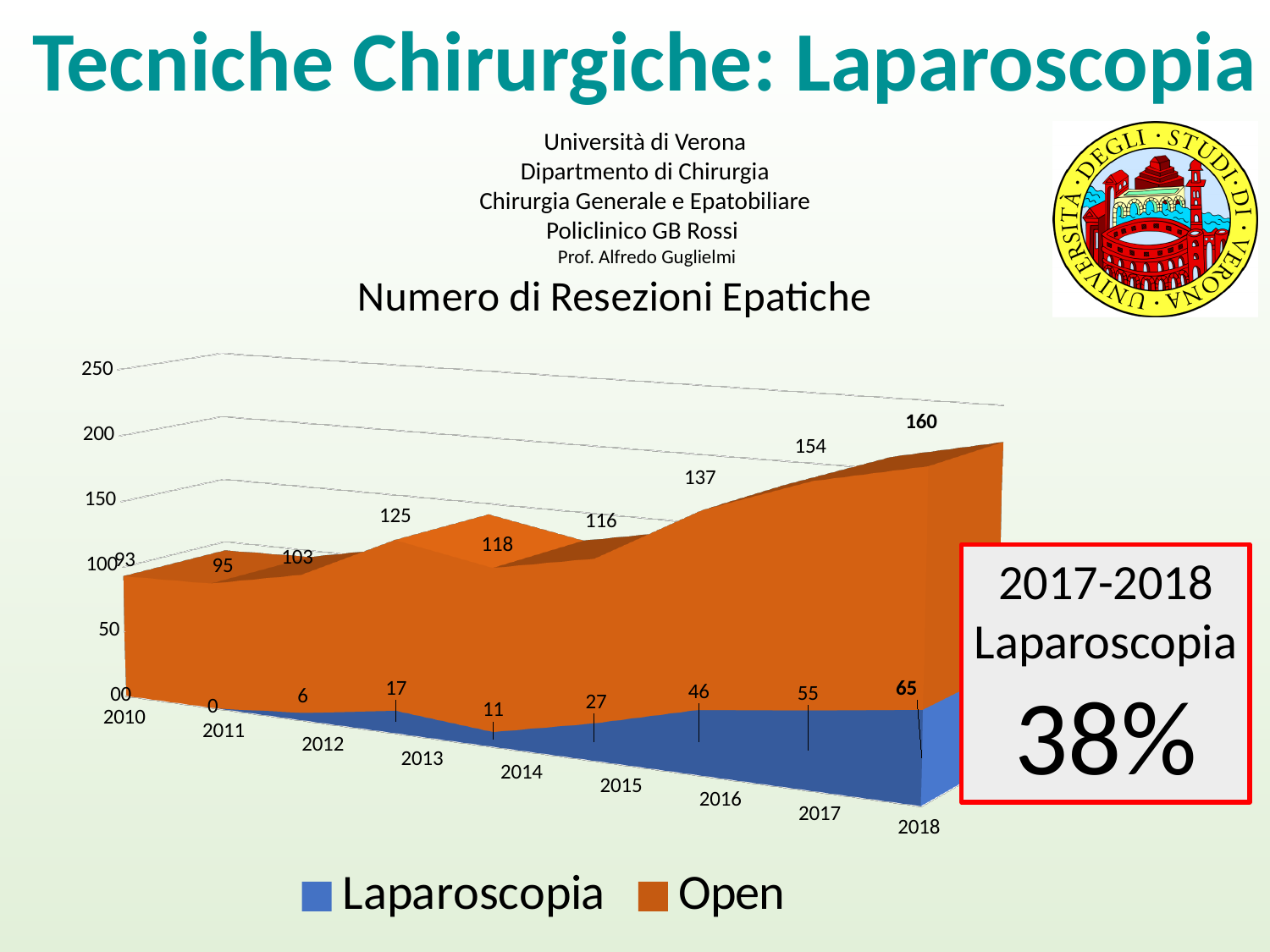
What is the difference between the Open values for 2017 and 2016? 17 What kind of chart is shown? Area chart What is the title of the chart? Numero di Resezioni Epatiche Which is larger, the Laparoscopia value for 2013 or for 2014? 2013 In which year is the Open series lowest? 2010 What is the value for Laparoscopia in 2014? 11 What is the value for Open in 2018? 160 In which year is the Open series highest? 2018 How many series does the legend list? 2 How many years are shown on the x axis? 9 What is the value for Open in 2013? 125 What is the value for Laparoscopia in 2017? 55